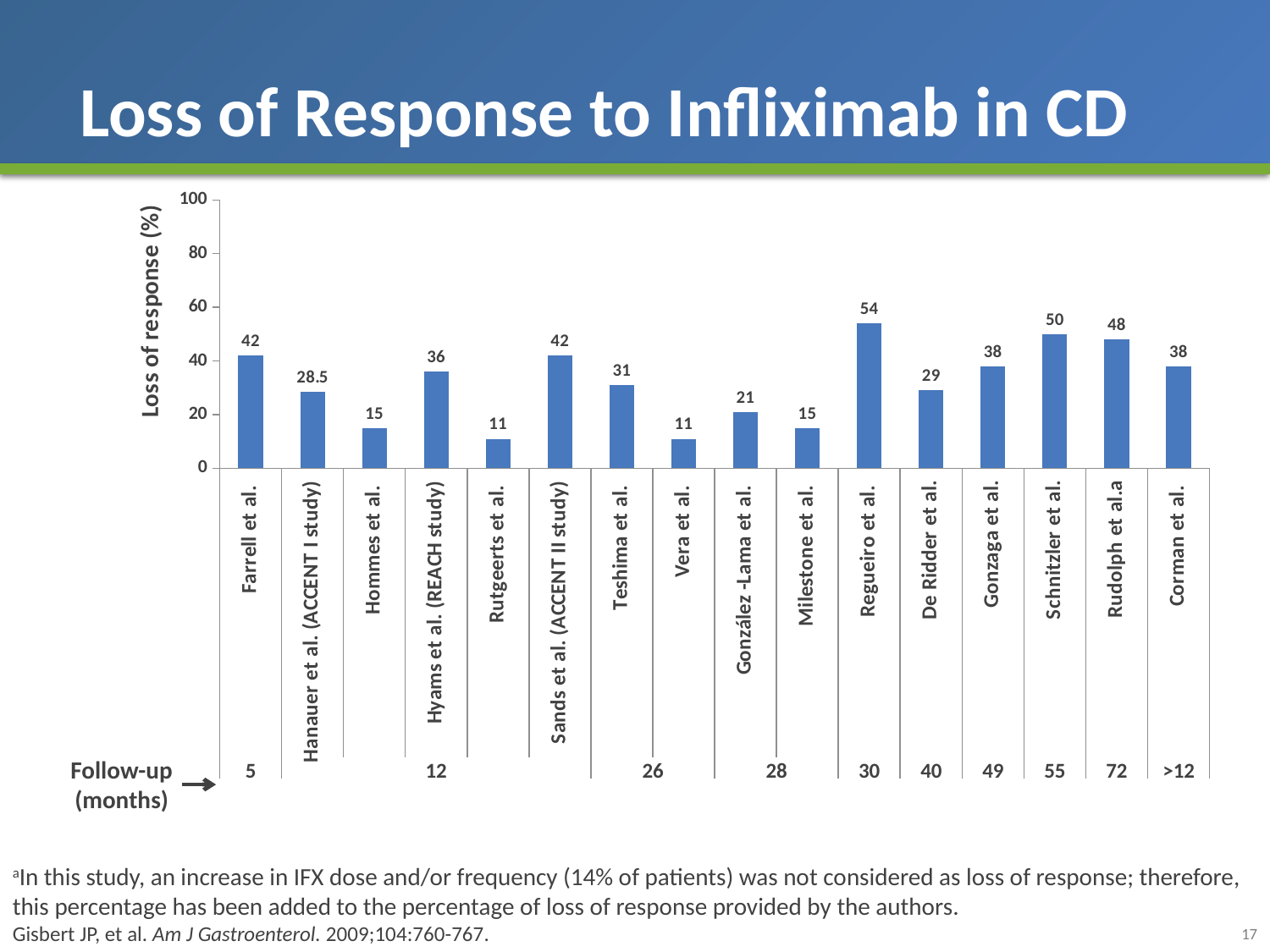
What is the difference in loss of response between Schnitzler et al. and Rudolph et al.? 2 Is the value for Sands et al. (ACCENT II study) greater or less than 40? greater What is the loss of response (%) for Hanauer et al. (ACCENT I study)? 28.5 What is the loss of response (%) for Teshima et al.? 31 What is the loss of response (%) for Hyams et al. (REACH study)? 36 How many studies are plotted in the chart? 16 What is the label of the y axis? Loss of response (%) Which has a higher loss of response, Gonzaga et al. or Hommes et al.? Gonzaga et al. What type of chart is shown on the slide? Bar chart Which study has the highest loss of response? Regueiro et al. What is the loss of response (%) for Regueiro et al.? 54 What is the difference in loss of response between Regueiro et al. and De Ridder et al.? 25